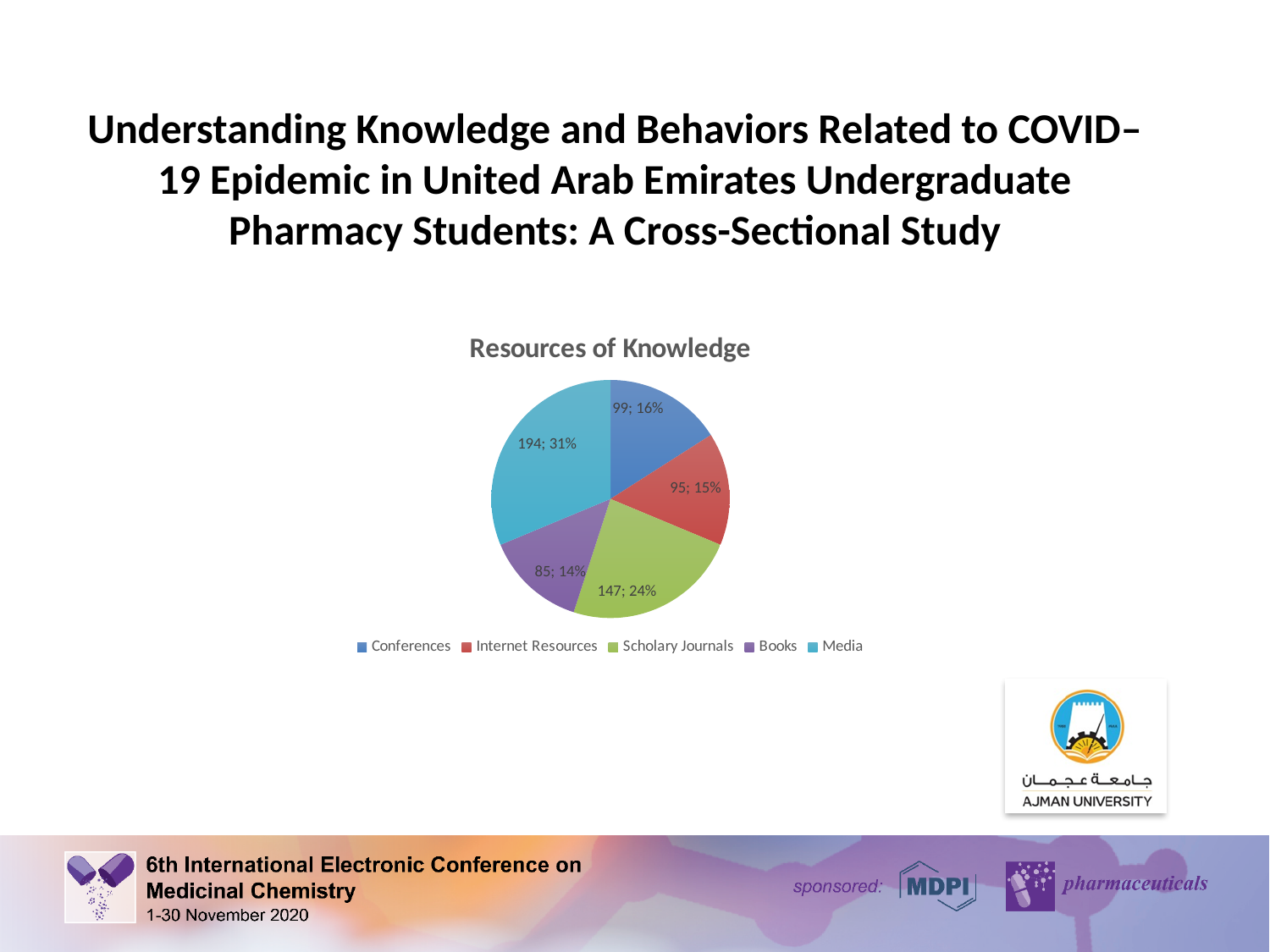
What percentage share does Conferences have in the Resources of Knowledge pie chart? 16% How many categories are shown in the Resources of Knowledge pie chart? 5 What is the difference between the values for Media and Scholary Journals in the Resources of Knowledge pie chart? 47 What is the value shown for Scholary Journals in the Resources of Knowledge pie chart? 147 What is the value shown for Media in the Resources of Knowledge pie chart? 194 What percentage share does Books have in the Resources of Knowledge pie chart? 14% Which is larger in the Resources of Knowledge pie chart, Scholary Journals or Internet Resources? Scholary Journals Which category has the smallest slice in the Resources of Knowledge pie chart? Books What is the total of all values in the Resources of Knowledge pie chart? 620 Which category has the largest slice in the Resources of Knowledge pie chart? Media What type of chart is used to show Resources of Knowledge? Pie chart What colour represents Internet Resources in the Resources of Knowledge pie chart? Red